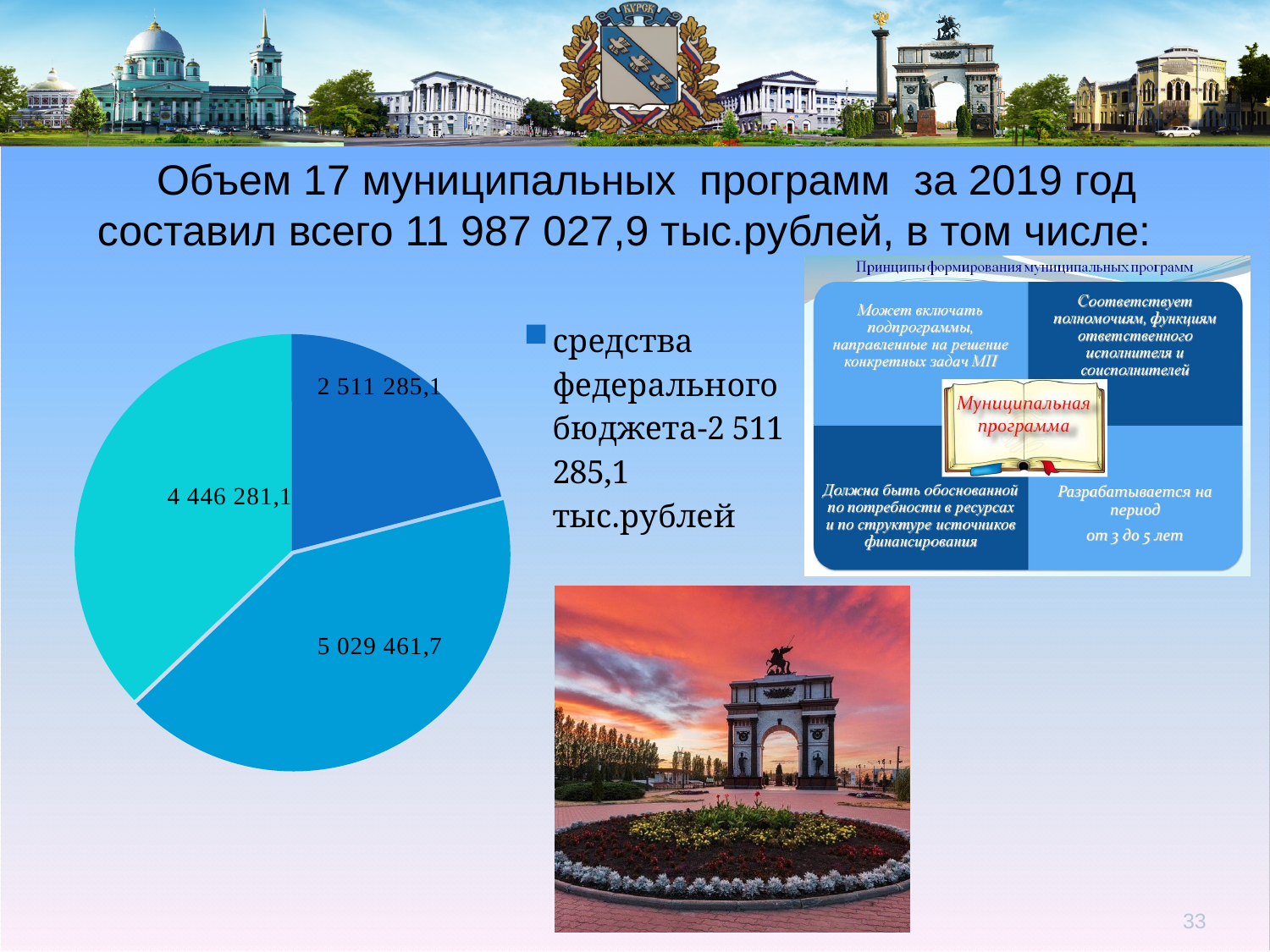
What is the difference between the largest slice (5 029 461,7) and the teal slice (4 446 281,1)? 583 180,6 What value is shown for средства федерального бюджета in the pie chart? 2 511 285,1 What is the value of the largest slice in the pie chart? 5 029 461,7 How many entries does the legend next to the pie chart list? 1 What colour is the slice for средства федерального бюджета in the pie chart? dark blue How many slices does the pie chart have? 3 What is the difference between the largest slice (5 029 461,7) and the federal budget slice (2 511 285,1)? 2 518 176,6 What is the value of the smallest slice in the pie chart? 2 511 285,1 What value is labelled on the teal (light green-blue) slice of the pie chart? 4 446 281,1 What is the total of the three values shown in the pie chart? 11 987 027,9 What kind of chart is shown on the slide? pie chart Which slice is larger: the teal slice (4 446 281,1) or the dark blue federal budget slice (2 511 285,1)? the teal slice (4 446 281,1)